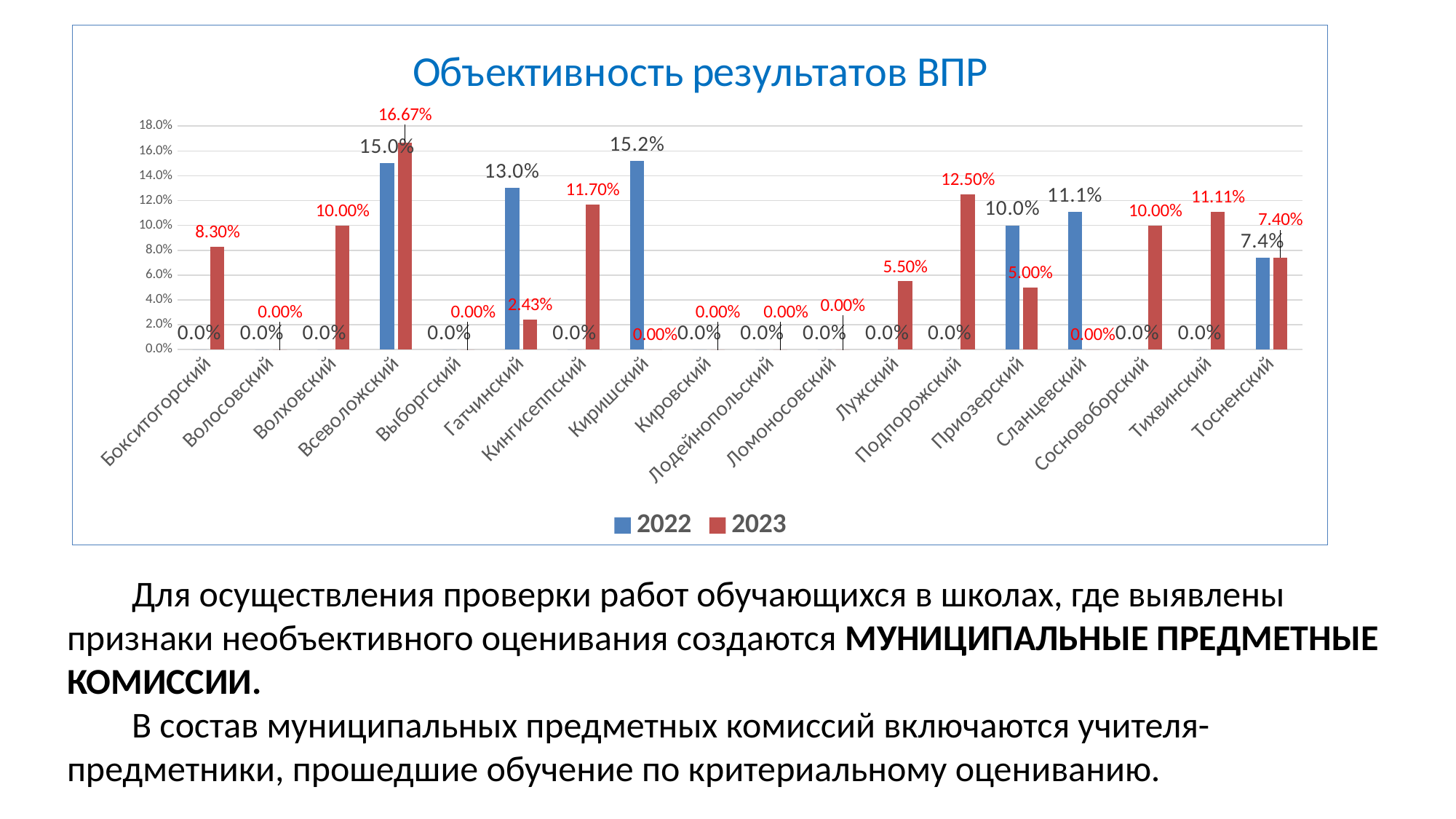
What type of chart is shown on the slide? bar chart Which district has the highest 2022 value? Киришский What is the difference between the 2022 and 2023 values for Приозерский? 5.00% What is the 2023 value for Тихвинский? 11.11% What is the title of the chart? Объективность результатов ВПР What is the 2022 value for Гатчинский? 13.0% Which district has the highest 2023 value? Всеволожский Which is larger for Приозерский: the 2022 value or the 2023 value? 2022 What is the 2023 value for Подпорожский? 12.50% How many series does the legend list? 2 What is the 2023 value for Всеволожский? 16.67% How many districts (categories) are shown on the x axis? 18